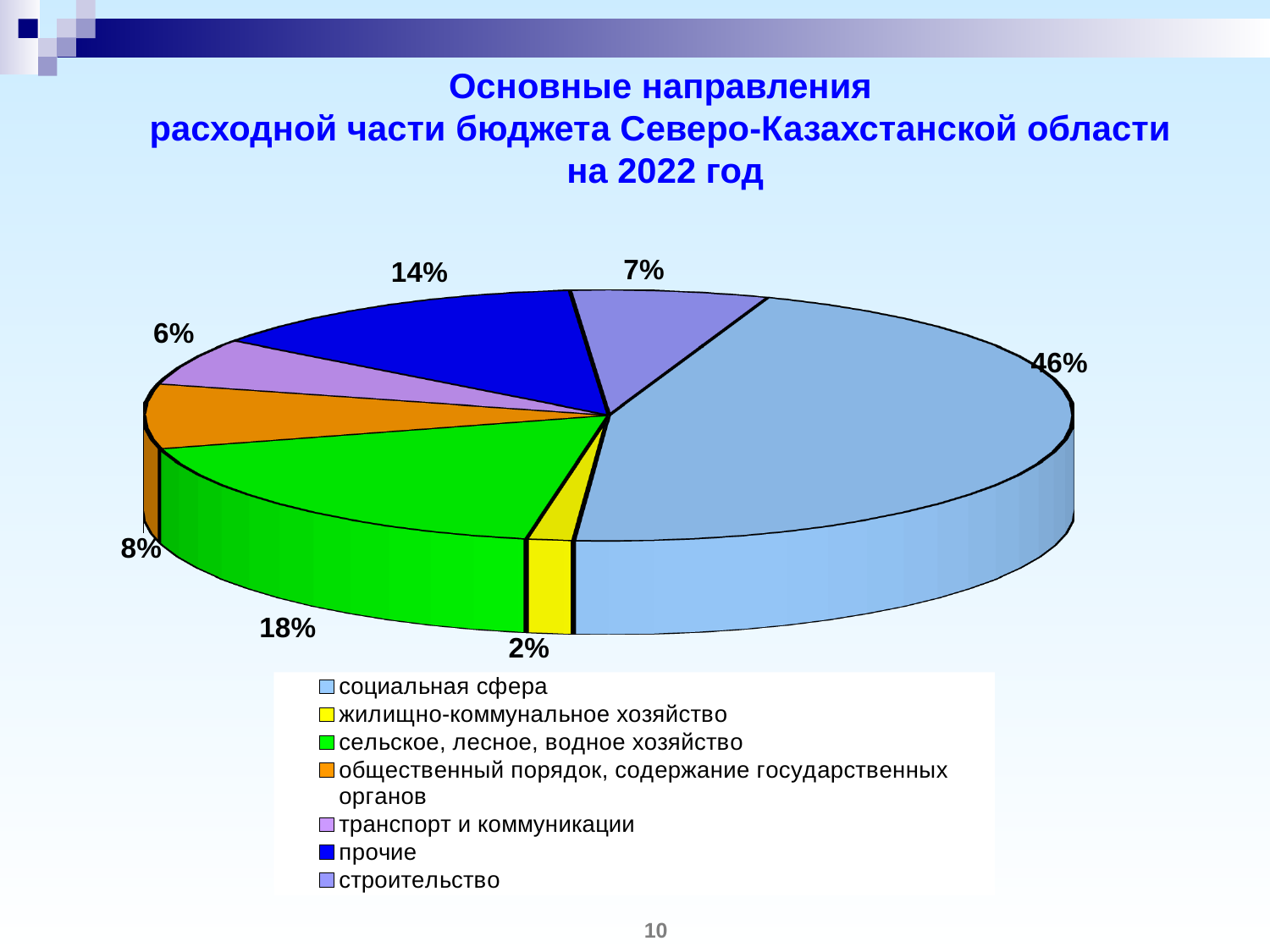
What share is shown for строительство? 7% Which category has the smallest share of the pie? жилищно-коммунальное хозяйство Which is larger: the share for прочие or the share for общественный порядок, содержание государственных органов? прочие How many categories does the legend list? 7 What share is shown for сельское, лесное, водное хозяйство? 18% What share of the budget expenditure goes to социальная сфера? 46% What type of chart is shown on the slide? pie chart What share is shown for жилищно-коммунальное хозяйство? 2% What is the difference between the shares of социальная сфера and сельское, лесное, водное хозяйство? 28% Which category has the largest share of the pie? социальная сфера Which category is shown in green? сельское, лесное, водное хозяйство What share is shown for прочие? 14%